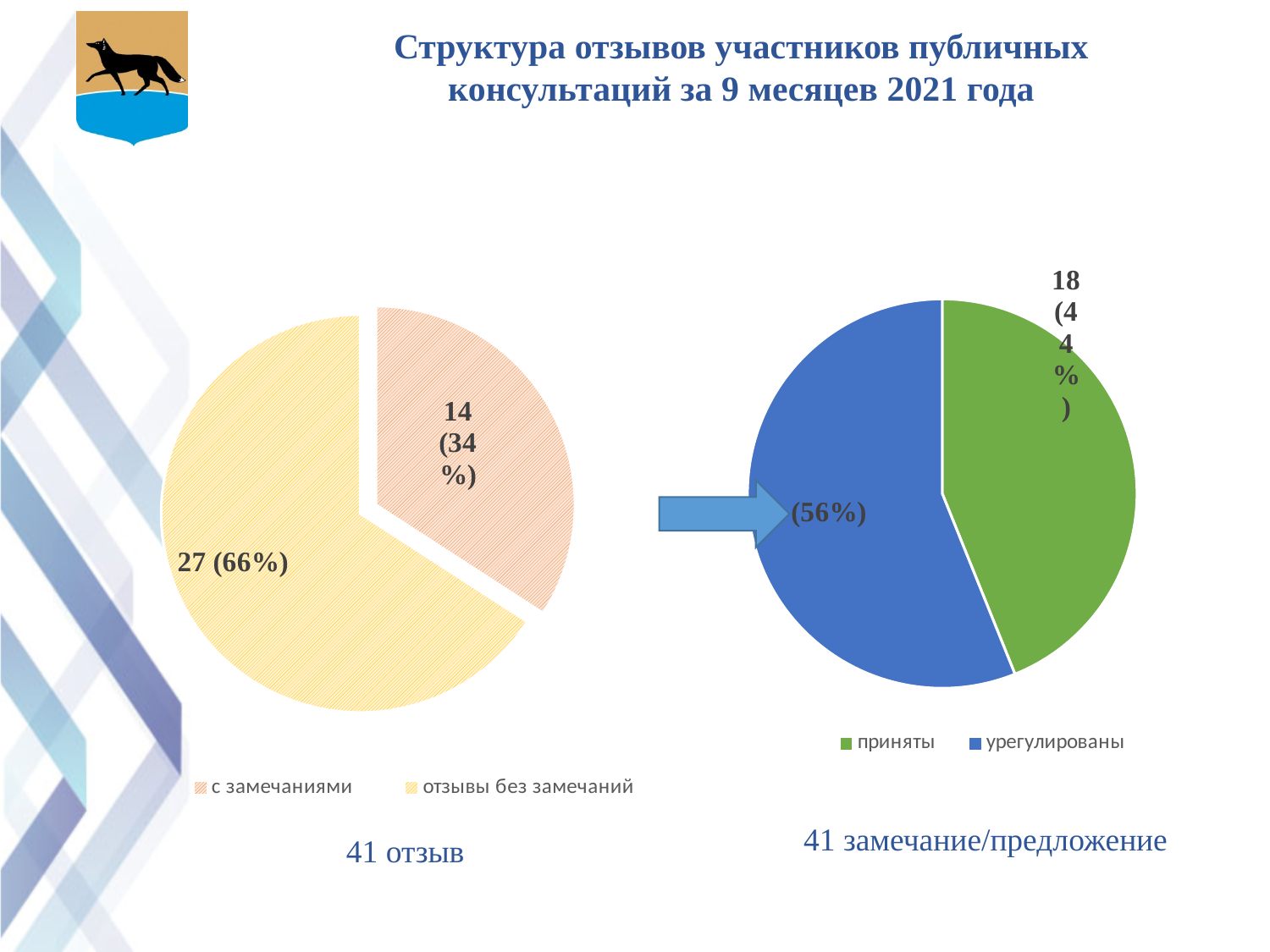
On the left pie chart, what share of reviews is 'с замечаниями'? 34% On the left pie chart, which category is the largest? отзывы без замечаний On the left pie chart, what is the difference between the number of 'отзывы без замечаний' and 'с замечаниями'? 13 What kind of chart is shown on the right side of the slide? pie chart On the left pie chart, what share of reviews is 'отзывы без замечаний'? 66% On the left pie chart, what is the total number of reviews across both slices? 41 On the right pie chart, how many items are labelled 'приняты'? 18 On the right pie chart, which is larger: 'приняты' or 'урегулированы'? урегулированы On the left pie chart, how many reviews are labelled 'с замечаниями'? 14 On the right pie chart, what share is 'урегулированы'? 56% How many entries does the legend of the right pie chart list? 2 On the right pie chart, which category is the smallest? приняты